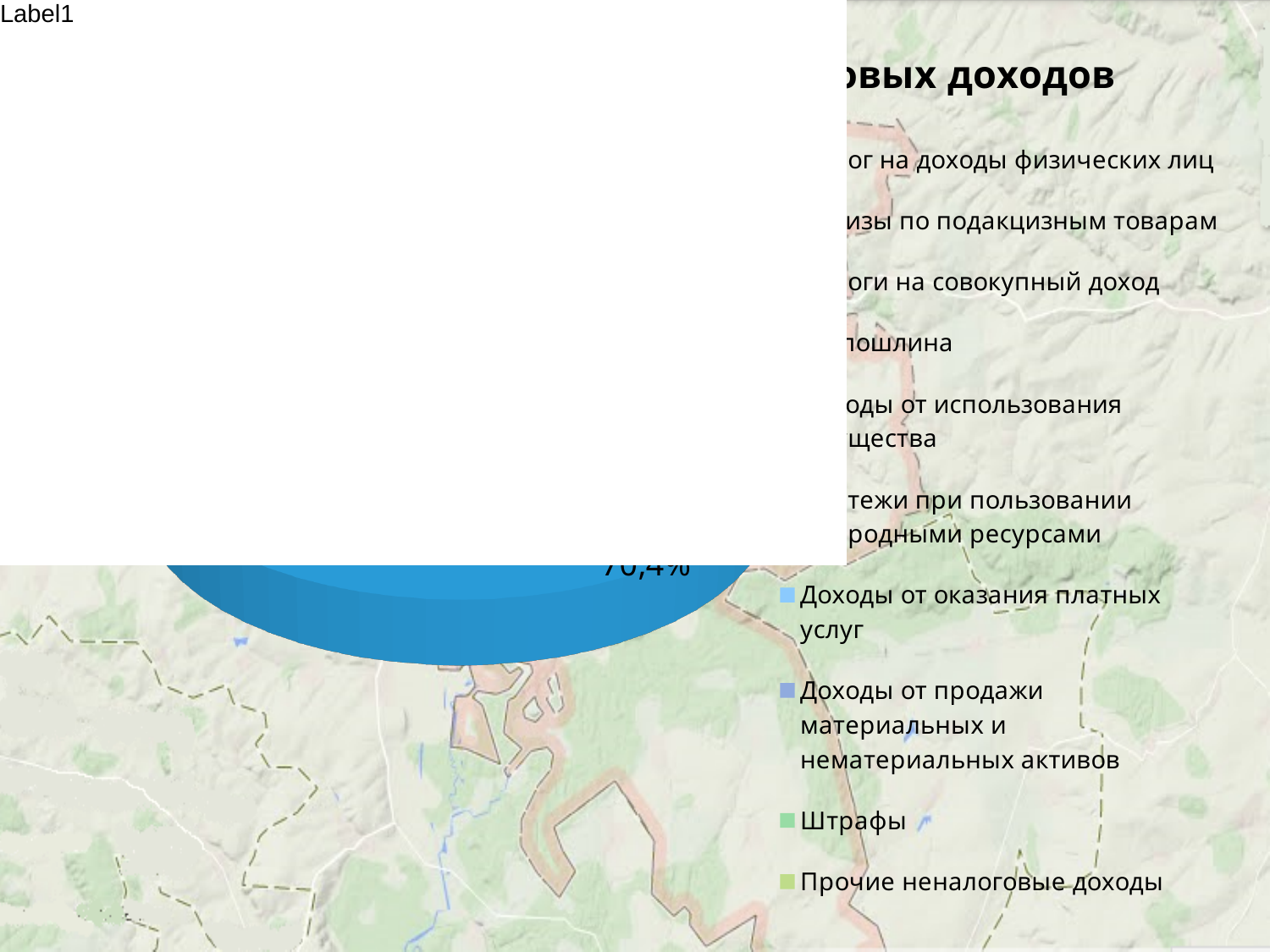
How many entries does the legend of the pie chart list? 10 What percentage label is printed on the large blue slice of the pie chart? 70,4% Is the value shown on the large blue slice of the pie chart greater or less than 50%? greater What is the last entry in the legend of the pie chart? Прочие неналоговые доходы Which legend entry of the pie chart comes immediately before "Штрафы"? Доходы от продажи материальных и нематериальных активов What kind of chart is shown on the slide? pie chart